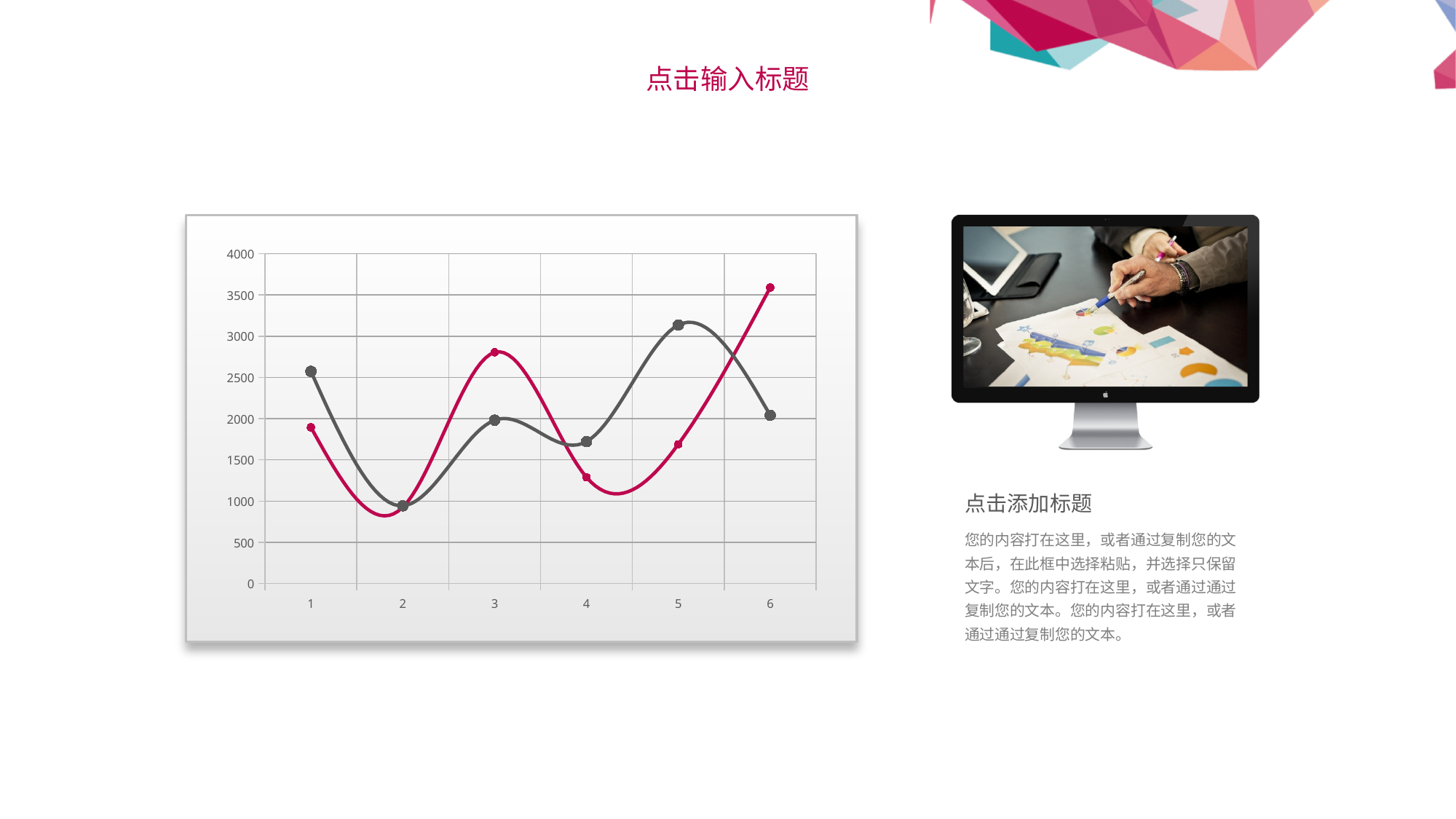
At category 6, which line has the higher value, the red line or the grey line? red line At which x-axis category does the grey line reach its highest value? 5 What kind of chart is shown on the slide? line chart How many lines (series) are plotted on the chart? 2 How many points are plotted along the x axis for each line? 6 At which x-axis category does the red line reach its highest value? 6 Is the value of the grey line at category 1 greater or less than 2000? greater Is the value of the red line at category 4 greater or less than 1500? less At which x-axis category does the red line reach its lowest value? 2 Is the value of the red line at category 3 greater or less than 2500? greater At category 1, which line has the higher value, the red line or the grey line? grey line